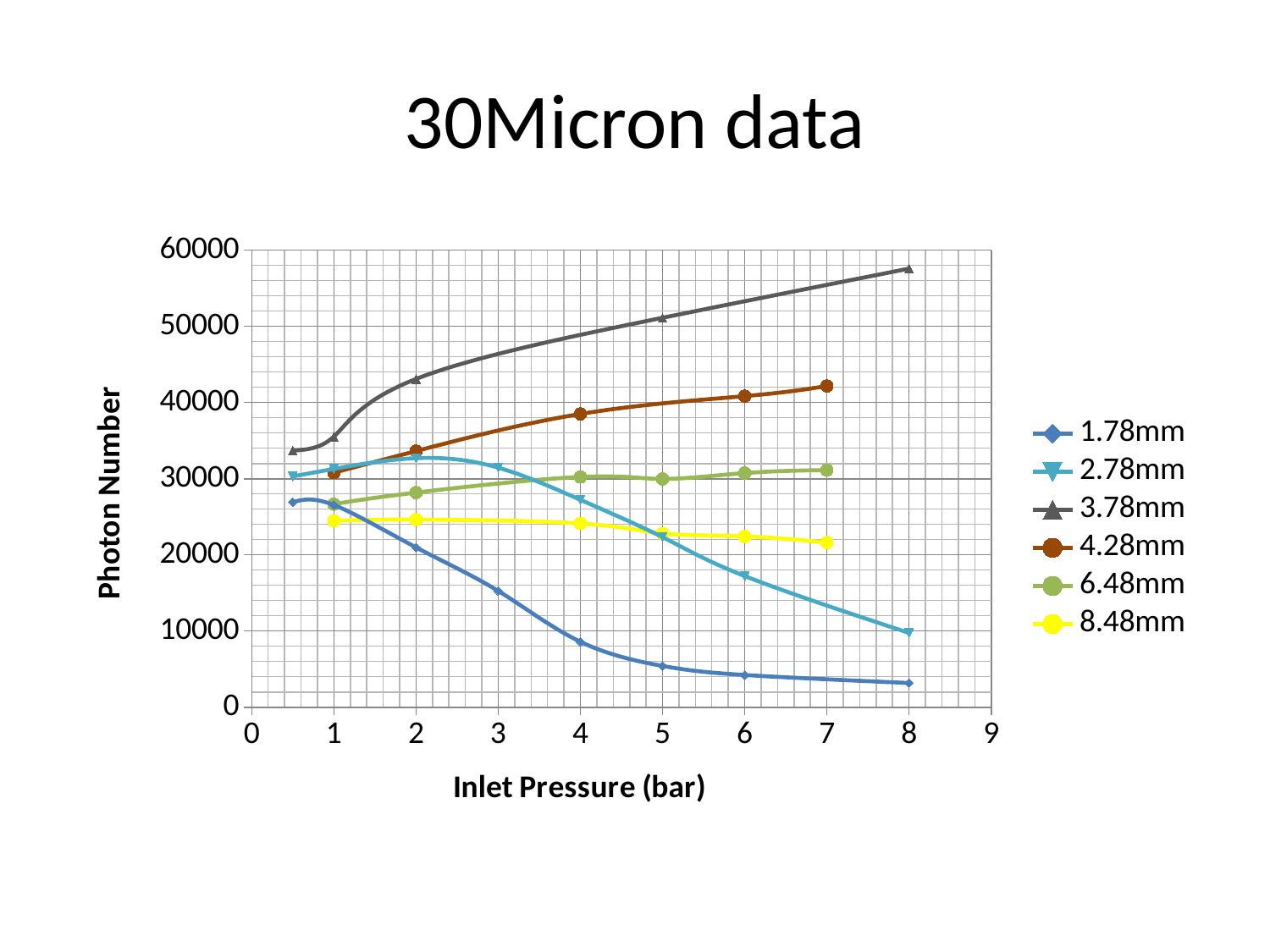
What kind of chart is shown on the slide? line chart Is the value for the 1.78mm series at 8 bar greater or less than 10000? less What is the label of the x axis? Inlet Pressure (bar) At 4 bar, which series has the larger photon number, 4.28mm or 6.48mm? 4.28mm Is the value for the 3.78mm series at 8 bar greater or less than 50000? greater What is the title of the chart? 30Micron data Does the 3.78mm series rise or fall as inlet pressure increases? rises How many series does the legend list? 6 Does the 1.78mm series rise or fall as inlet pressure increases? falls Which series has the lowest photon number at 7 bar? 1.78mm Is the value for the 8.48mm series at 7 bar greater or less than 30000? less Which series has the highest photon number at 7 bar? 3.78mm